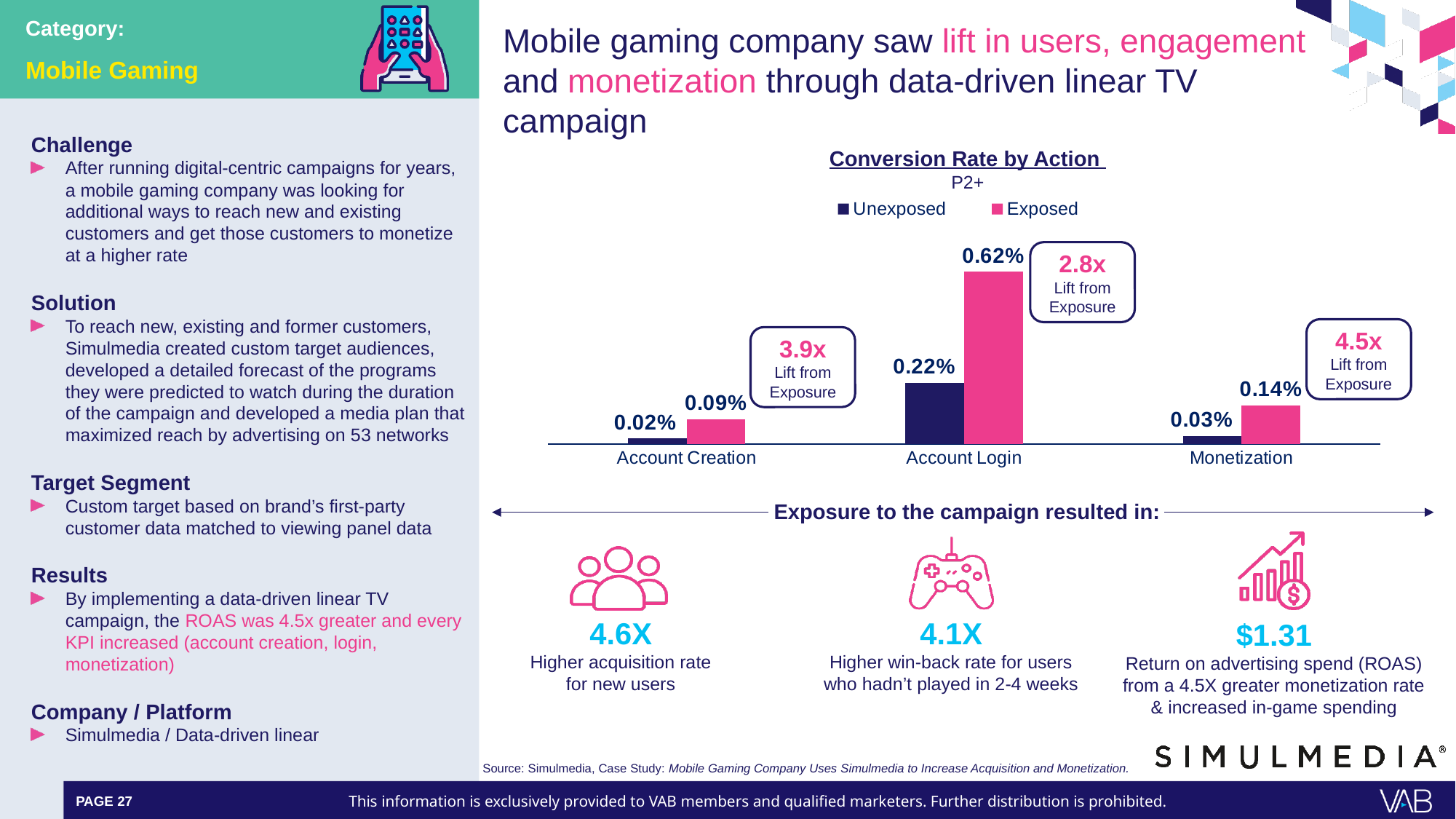
What is the Unexposed conversion rate for Account Creation? 0.02% How many series does the legend of the Conversion Rate by Action chart list? 2 What type of chart is the Conversion Rate by Action chart? Bar chart Which is larger: the Exposed conversion rate for Monetization or the Exposed conversion rate for Account Creation? Exposed conversion rate for Monetization Which action has the highest Exposed conversion rate? Account Login What lift from exposure is shown in the callout for Monetization? 4.5x What is the Exposed conversion rate for Account Login? 0.62% Which action has the lowest Unexposed conversion rate? Account Creation What is the Unexposed conversion rate for Account Login? 0.22% What is the Exposed conversion rate for Monetization? 0.14% What is the difference between the Exposed and Unexposed conversion rates for Account Login? 0.40% How many actions (categories) are shown on the x axis of the Conversion Rate by Action chart? 3